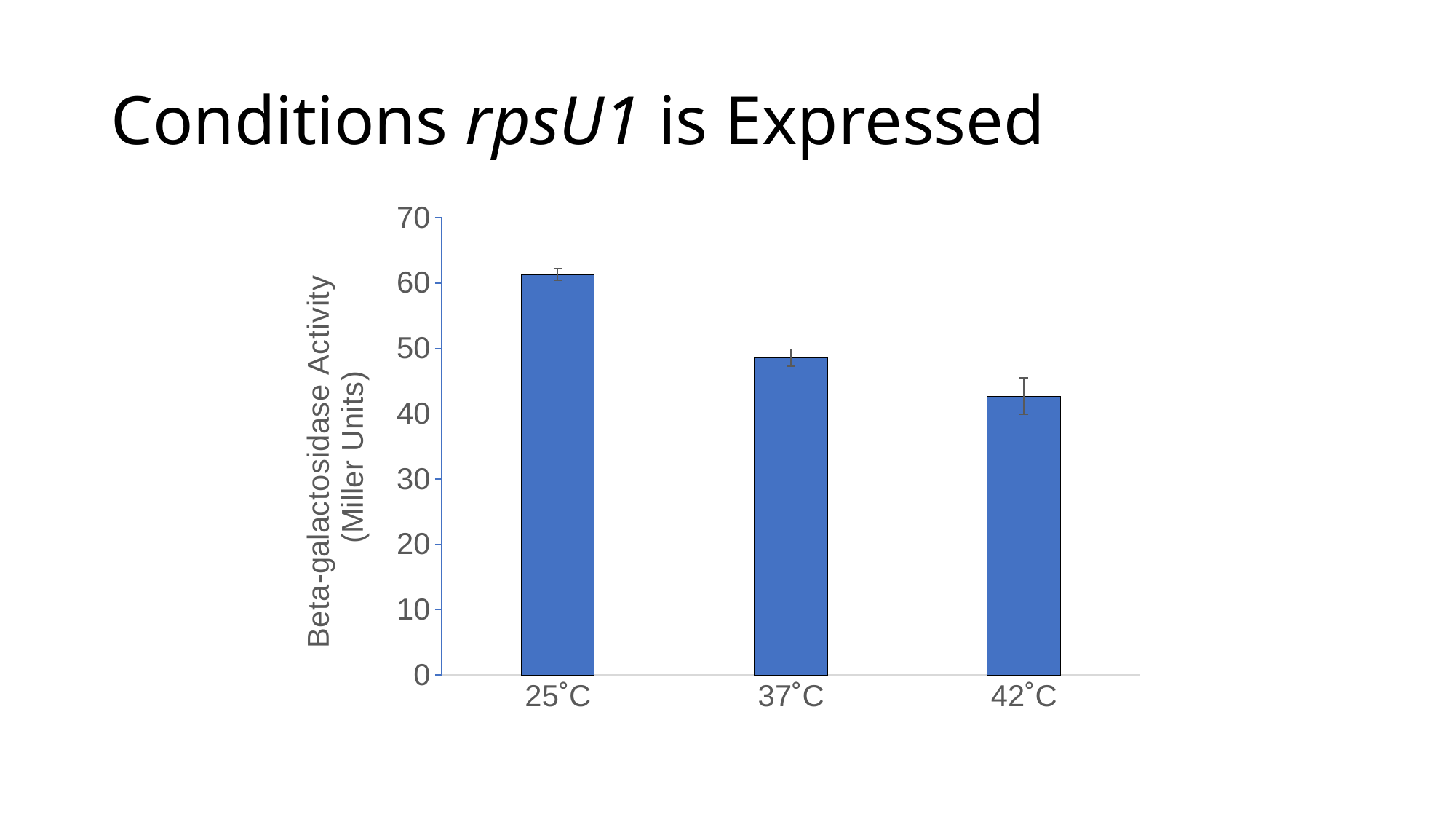
Is the beta-galactosidase activity at 42°C greater or less than 40? greater Which has higher beta-galactosidase activity, 37°C or 42°C? 37°C Do the values rise or fall as temperature increases along the x axis? fall What is the label of the y axis? Beta-galactosidase Activity (Miller Units) What is the maximum value shown on the y axis? 70 Which temperature has the highest beta-galactosidase activity? 25°C Which temperature has the lowest beta-galactosidase activity? 42°C Is the beta-galactosidase activity at 37°C greater or less than 50? less How many temperature categories are plotted on the x axis? 3 What is the title of the slide? Conditions rpsU1 is Expressed What kind of chart is shown on the slide? bar chart Is the beta-galactosidase activity at 25°C greater or less than 60? greater